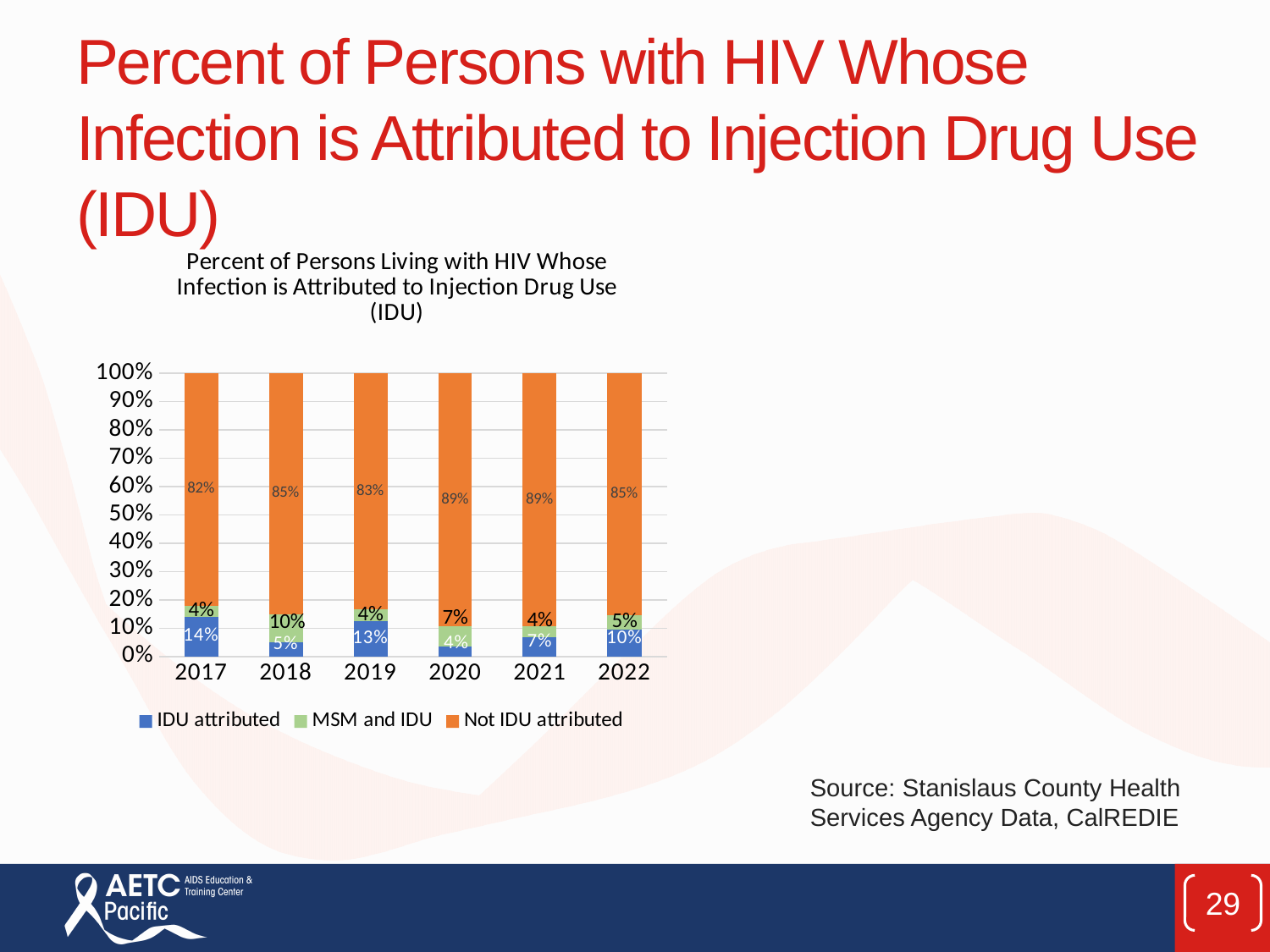
What type of chart is shown on the slide? Stacked bar chart In which year is the IDU attributed share the lowest? 2020 What is the difference between the IDU attributed values for 2017 and 2018? 9% In which year is the IDU attributed share the highest? 2017 Which is larger, the MSM and IDU value for 2020 or for 2021? 2020 What is the MSM and IDU value for 2018? 10% What is the IDU attributed value for 2022? 10% Which series is shown in orange in the chart? Not IDU attributed How many series does the chart legend list? 3 What is the Not IDU attributed value for 2020? 89% How many years are shown on the x axis of the chart? 6 What percentage of persons with HIV had infection attributed to IDU (IDU attributed) in 2017? 14%